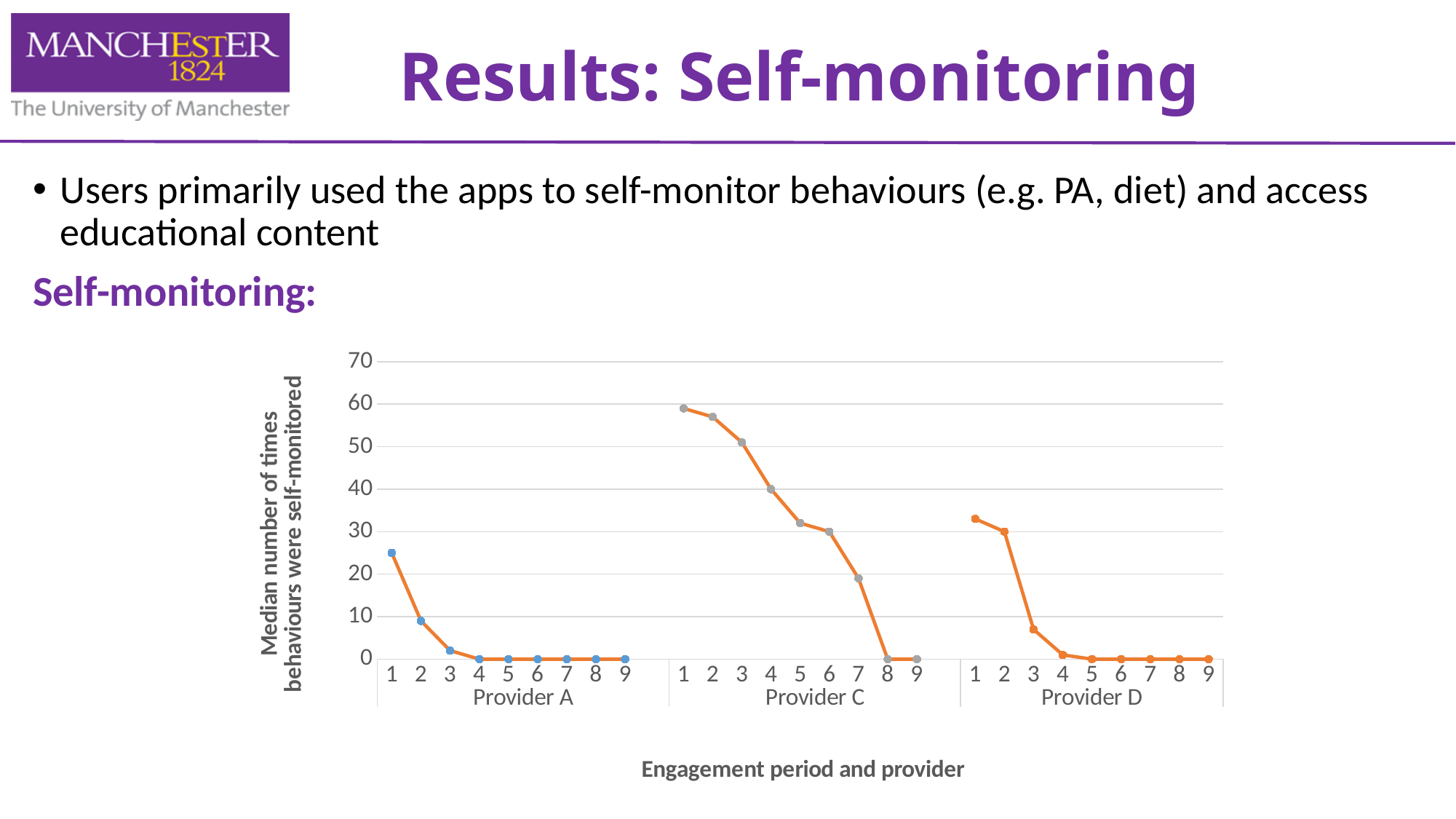
How many engagement periods are plotted for each provider? 9 How many providers are shown on the x axis of the chart? 3 Do the values for Provider C rise or fall across the engagement periods? fall What is the title of the y axis of the chart? Median number of times behaviours were self-monitored Is the value for Provider D at engagement period 1 greater or less than 30? greater What kind of chart is shown on the slide? line chart What is the value for Provider C at engagement period 9? 0 Is the value for Provider C at engagement period 1 greater or less than 50? greater Which provider has the highest value at engagement period 1? Provider C Is the value for Provider C at engagement period 7 greater or less than 10? greater What is the value for Provider A at engagement period 9? 0